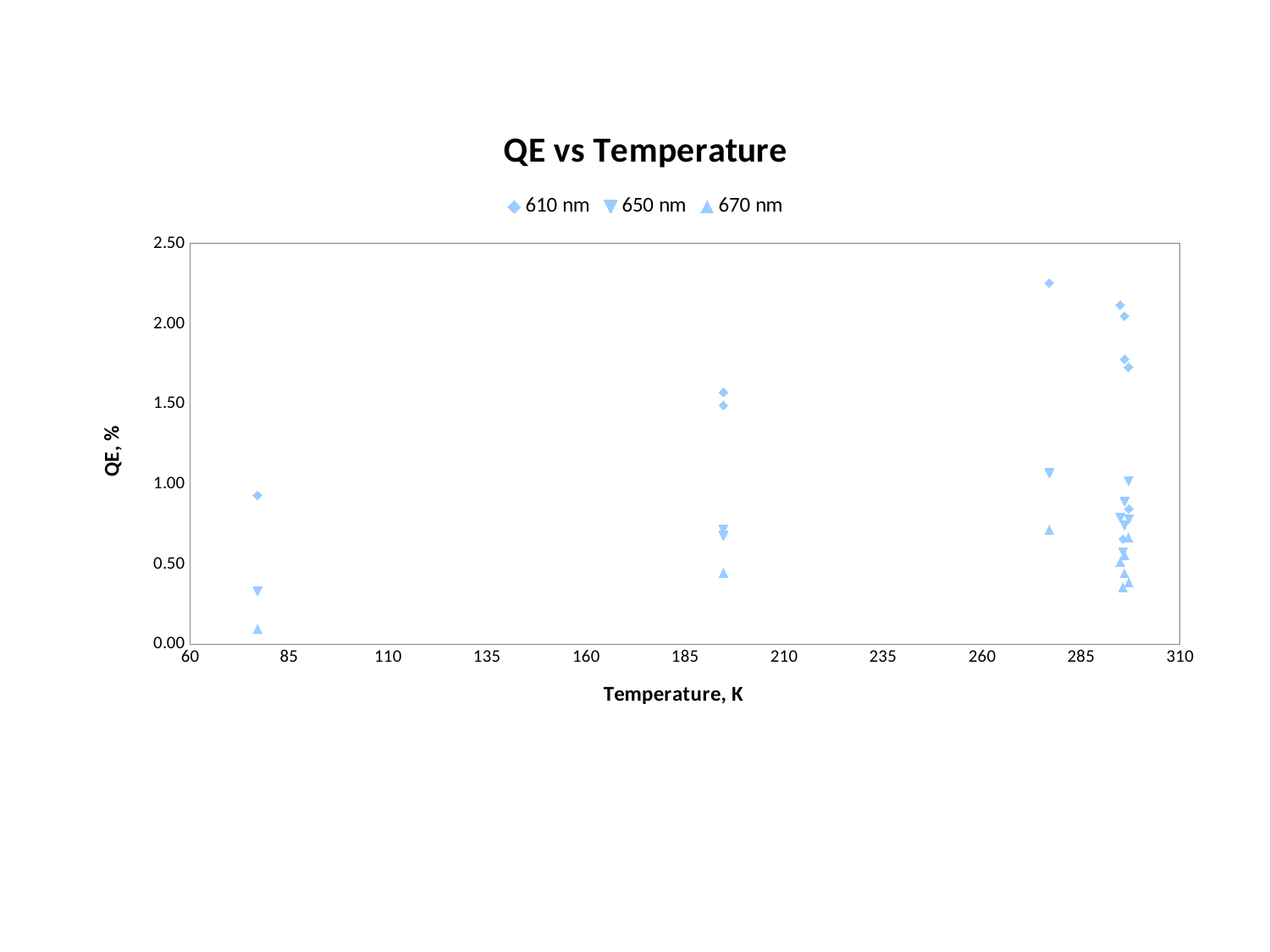
Which series has the lowest QE value on the chart? 670 nm Are the QE values for the 610 nm series near 195 K greater or less than 1.00? greater What is the title of the chart? QE vs Temperature How many series does the legend list? 3 Which series reaches the highest QE value on the chart? 610 nm Do the QE values for the 610 nm series generally rise or fall as temperature increases? rise What is the label of the x axis? Temperature, K Is the QE value for the 670 nm series at the lowest temperature (around 77 K) greater or less than 0.50? less At the lowest temperature (around 77 K), which series has the higher QE, 610 nm or 670 nm? 610 nm What kind of chart is shown on the slide? scatter chart Is the QE value for the 650 nm series at the lowest temperature (around 77 K) greater or less than 0.50? less